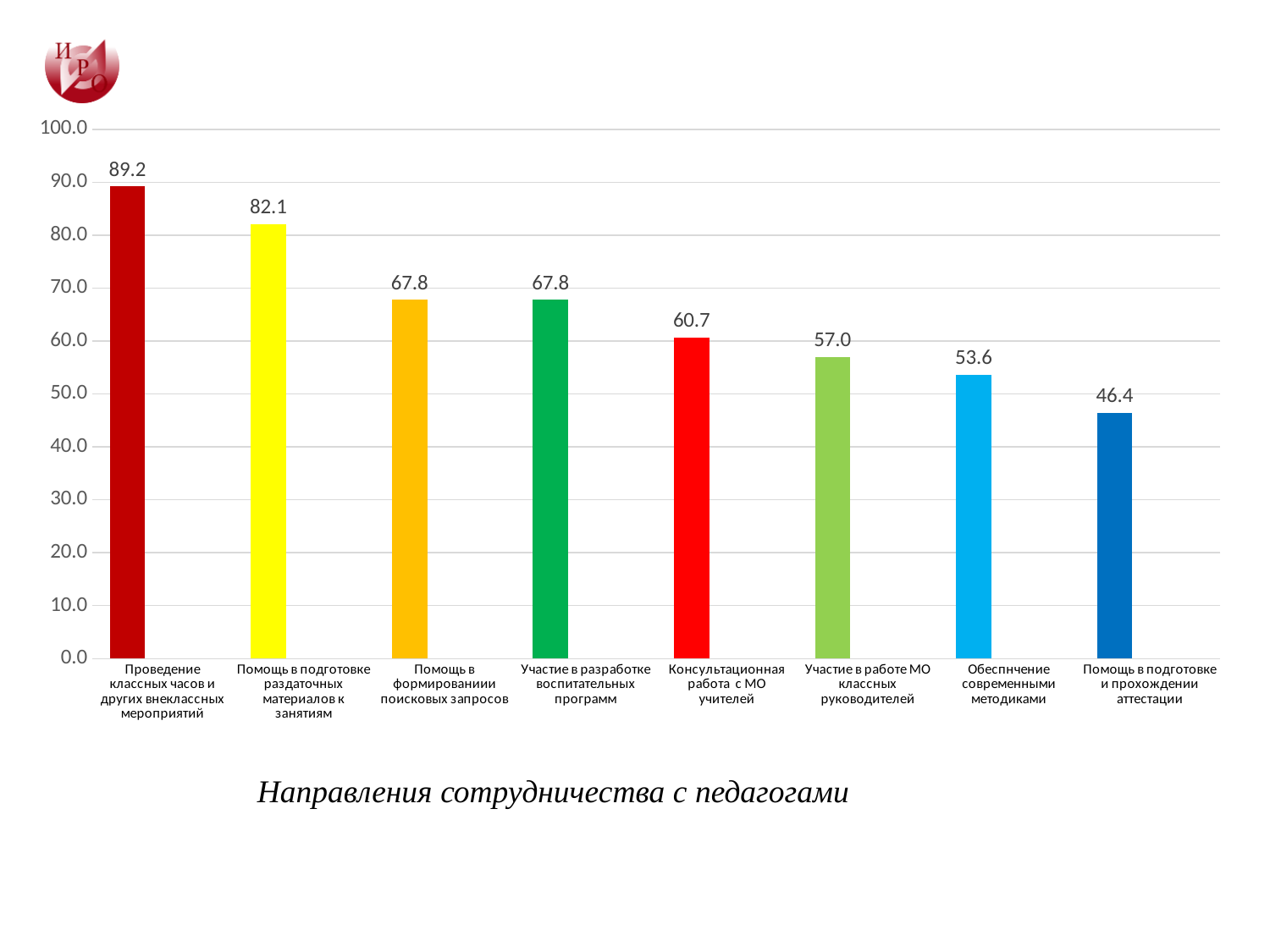
What is the value for «Проведение классных часов и других внеклассных мероприятий»? 89.2 Which is larger: the value for «Обеспнчение современными методиками» or the value for «Участие в работе МО классных руководителей»? Участие в работе МО классных руководителей What is the value for «Помощь в подготовке и прохождении аттестации»? 46.4 What is the difference between the values for «Помощь в подготовке раздаточных материалов к занятиям» and «Участие в работе МО классных руководителей»? 25.1 Do the values rise or fall from left to right along the x axis? Fall Is the value for «Помощь в формированиии поисковых запросов» greater or less than 60.0? greater What kind of chart is shown on the slide? Bar chart Which category has the lowest value? Помощь в подготовке и прохождении аттестации How many categories are shown in the chart? 8 Which category has the highest value? Проведение классных часов и других внеклассных мероприятий What is the value for «Консультационная работа с МО учителей»? 60.7 What is the caption below the chart? Направления сотрудничества с педагогами